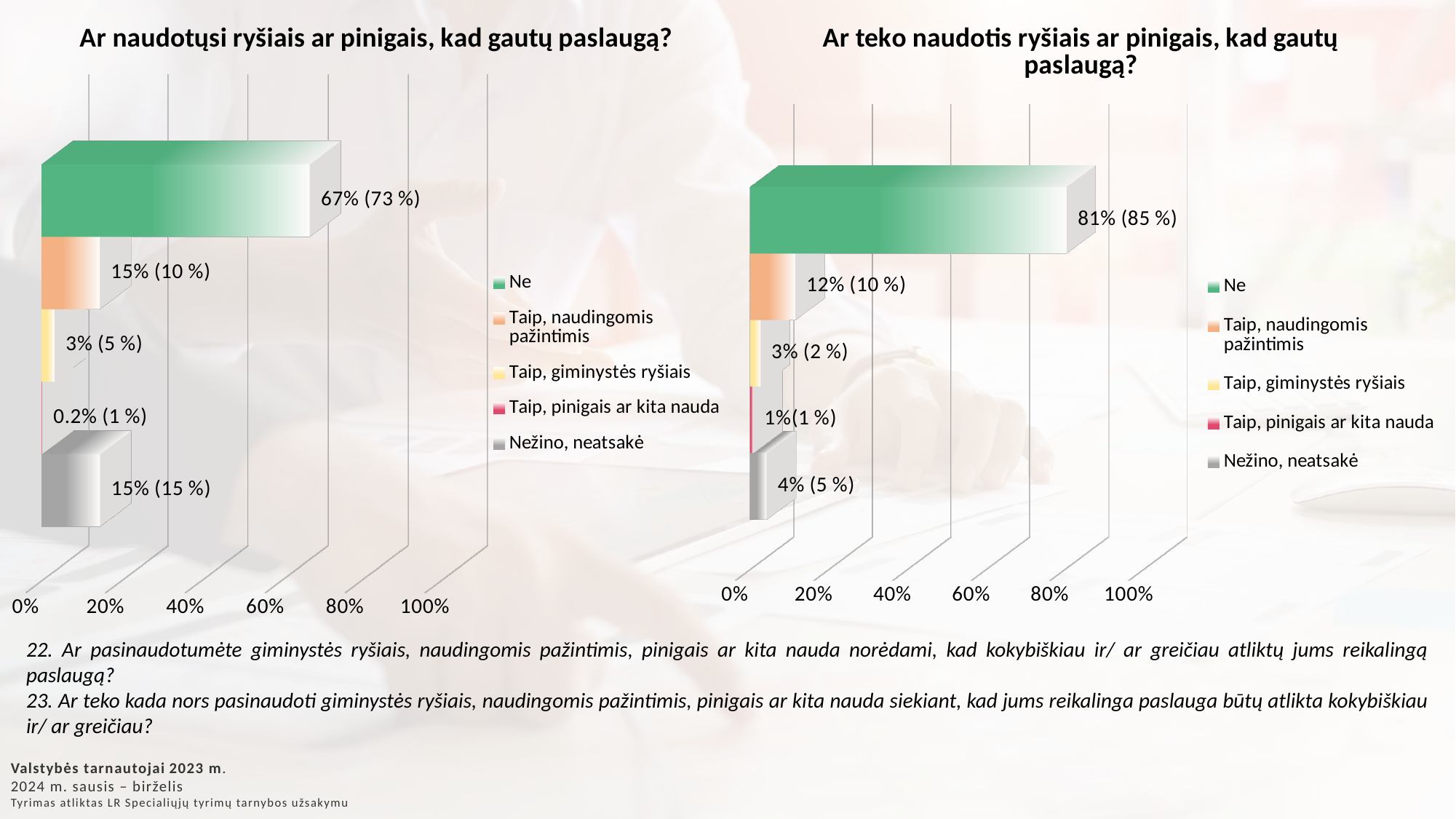
In the left chart, which is larger: 'Taip, naudingomis pažintimis' or 'Taip, giminystės ryšiais'? Taip, naudingomis pažintimis In the left chart 'Ar naudotųsi ryšiais ar pinigais, kad gautų paslaugą?', what data label is shown for 'Ne'? 67% (73 %) What kind of chart is the right chart? bar chart In the right chart, which category has the highest value? Ne How many categories does the legend of the left chart list? 5 Using the first percentage in each label, what is the difference between 'Ne' in the right chart (81%) and 'Ne' in the left chart (67%)? 14 percentage points What colour is the 'Ne' bar in both charts? green In the left chart, what data label is shown for 'Taip, pinigais ar kita nauda'? 0.2% (1 %) In the left chart, which category has the lowest value? Taip, pinigais ar kita nauda In the right chart, is the value for 'Ne' greater or less than 80%? greater In the right chart 'Ar teko naudotis ryšiais ar pinigais, kad gautų paslaugą?', what data label is shown for 'Ne'? 81% (85 %) In the right chart, what data label is shown for 'Nežino, neatsakė'? 4% (5 %)